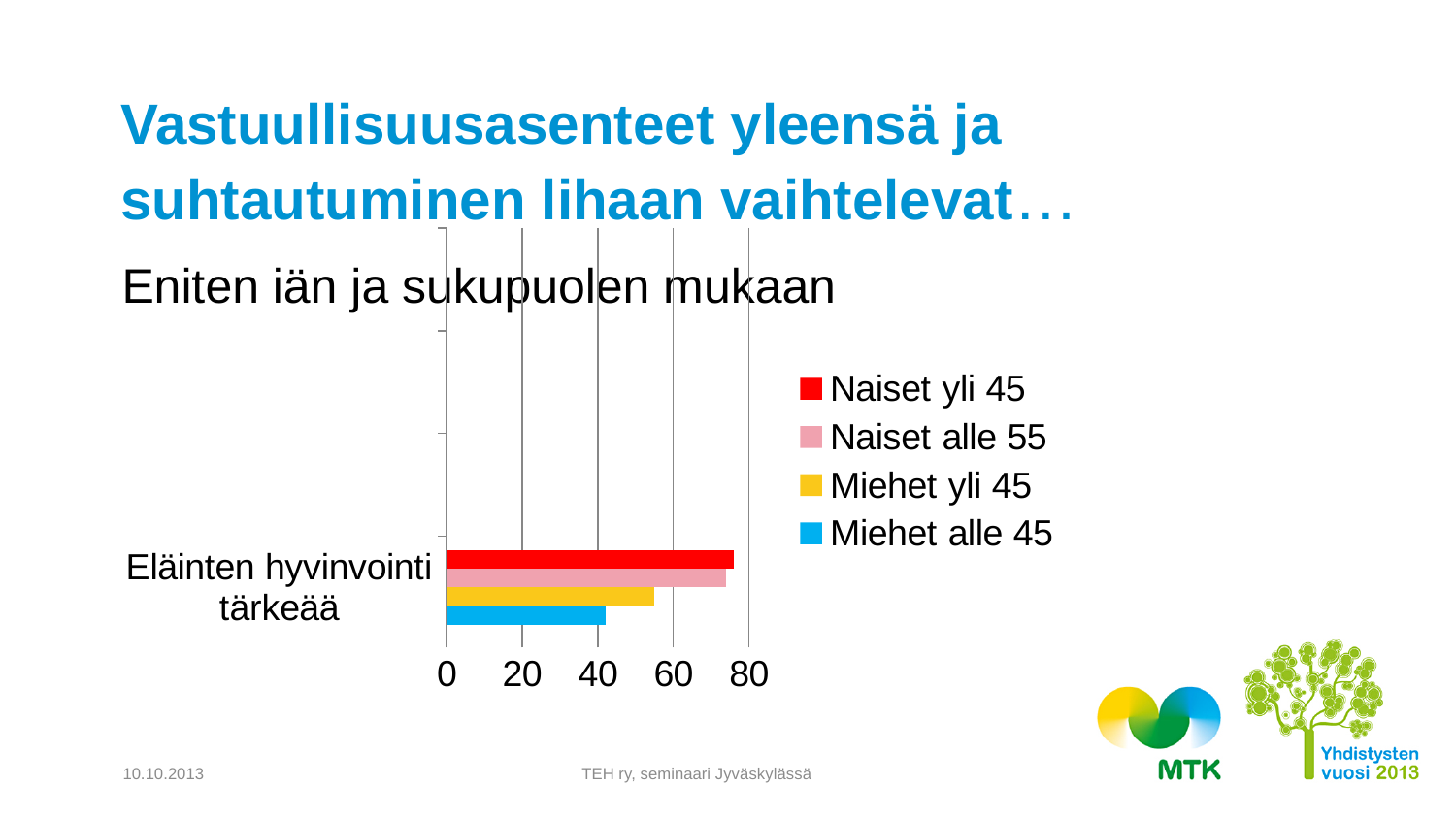
Is the value for Naiset yli 45 greater or less than 60? greater Is the value for Miehet alle 45 greater or less than 60? less How many categories are plotted on the chart? 1 Which is larger, the value for Miehet yli 45 or the value for Miehet alle 45? Miehet yli 45 How many series does the chart legend list? 4 Is the value for Naiset alle 55 greater or less than 80? less What colour represents the Miehet alle 45 series in the chart? Blue Which is larger, the value for Naiset alle 55 or the value for Miehet yli 45? Naiset alle 55 Which series has the lowest value for Eläinten hyvinvointi tärkeää? Miehet alle 45 What is the label of the category plotted on the chart? Eläinten hyvinvointi tärkeää What kind of chart is shown on the slide? Bar chart